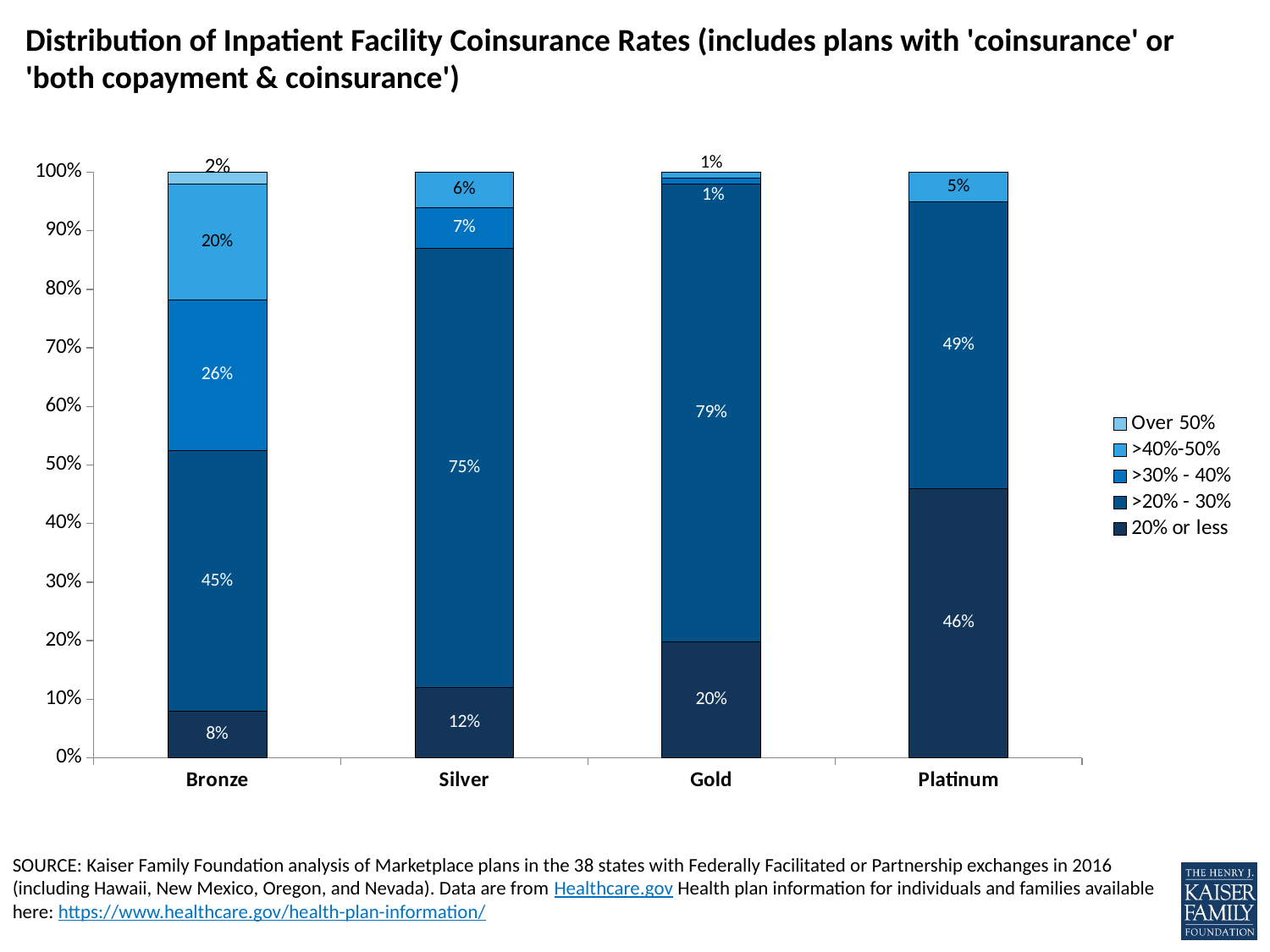
Which is larger: the >20% - 30% share for Bronze or for Platinum? Platinum How many metal tiers (categories) are shown on the x axis? 4 What share of Bronze plans have an inpatient facility coinsurance rate of 20% or less? 8% What kind of chart is shown on the slide? Stacked bar chart How many percentage points larger is the >20% - 30% share for Gold than for Silver? 4 percentage points What share of Platinum plans have a coinsurance rate of 20% or less? 46% What share of Gold plans fall in the >20% - 30% coinsurance band? 79% What share of Bronze plans fall in the >30% - 40% coinsurance band? 26% Which metal tier has the largest share of plans with coinsurance of 20% or less? Platinum How many series does the legend list? 5 What share of Silver plans fall in the >20% - 30% coinsurance band? 75% Which metal tier has the smallest share of plans with coinsurance of 20% or less? Bronze